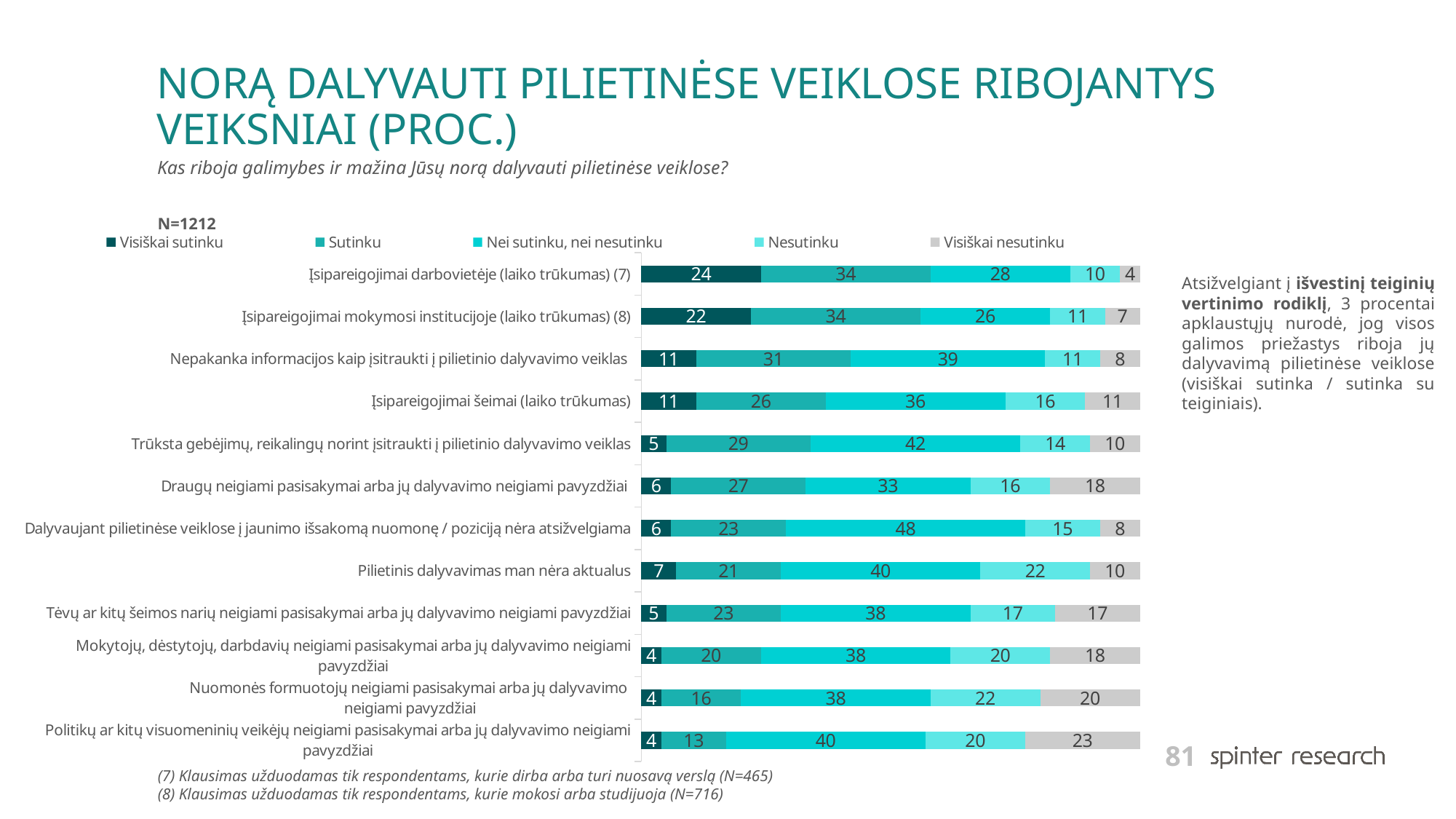
What is the 'Visiškai nesutinku' value for 'Politikų ar kitų visuomeninių veikėjų neigiami pasisakymai arba jų dalyvavimo neigiami pavyzdžiai'? 23 What is the 'Visiškai sutinku' value for 'Įsipareigojimai darbovietėje (laiko trūkumas) (7)'? 24 What type of chart is shown on the slide? Stacked bar chart What is the difference between the 'Nei sutinku, nei nesutinku' values for 'Trūksta gebėjimų, reikalingų norint įsitraukti į pilietinio dalyvavimo veiklas' and 'Įsipareigojimai šeimai (laiko trūkumas)'? 6 What is the 'Nei sutinku, nei nesutinku' value for 'Dalyvaujant pilietinėse veiklose į jaunimo išsakomą nuomonę / poziciją nėra atsižvelgiama'? 48 How many categories (statements) are plotted in the chart? 12 How many series does the legend list? 5 What is the total of the stacked bar for 'Nepakanka informacijos kaip įsitraukti į pilietinio dalyvavimo veiklas'? 100 Which category has the lowest 'Sutinku' value? Politikų ar kitų visuomeninių veikėjų neigiami pasisakymai arba jų dalyvavimo neigiami pavyzdžiai Which is larger: the 'Nesutinku' value for 'Pilietinis dalyvavimas man nėra aktualus' or for 'Įsipareigojimai šeimai (laiko trūkumas)'? Pilietinis dalyvavimas man nėra aktualus What sample size (N) is shown above the chart? N=1212 Which category has the highest 'Visiškai sutinku' value? Įsipareigojimai darbovietėje (laiko trūkumas) (7)